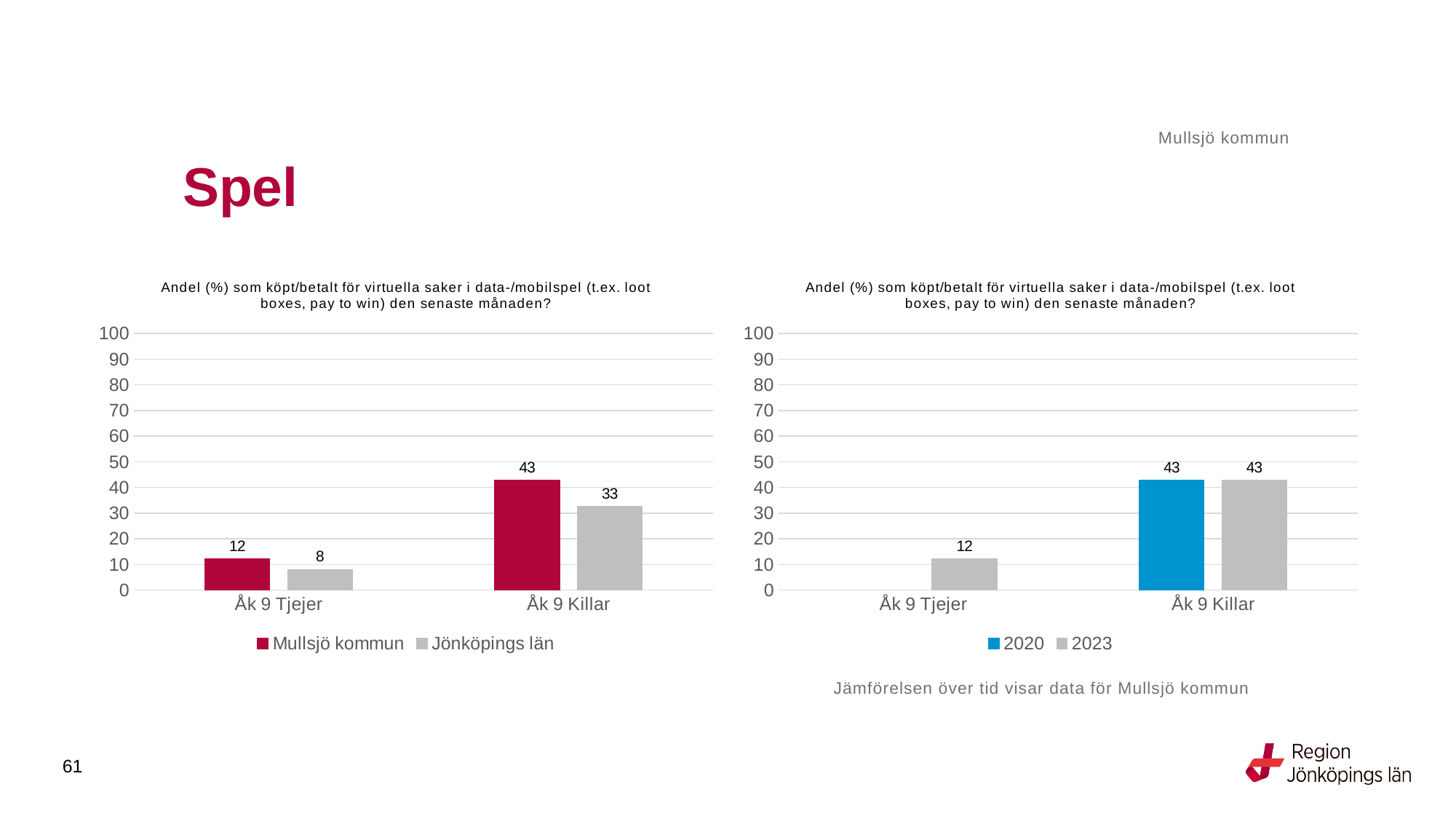
What kind of chart is the right chart? Bar chart How many categories are shown on the x axis of the right chart? 2 In the left chart, what is the value for Mullsjö kommun for Åk 9 Killar? 43 In the left chart, which category has the highest value for Jönköpings län? Åk 9 Killar In the right chart, which series is shown in blue? 2020 In the left chart, what is the difference between Mullsjö kommun and Jönköpings län for Åk 9 Killar? 10 In the right chart, what is the difference between 2020 and 2023 for Åk 9 Killar? 0 In the right chart, what is the value for 2020 for Åk 9 Killar? 43 In the right chart, what is the value for 2023 for Åk 9 Tjejer? 12 In the left chart, what is the value for Jönköpings län for Åk 9 Tjejer? 8 How many series does the legend of the left chart list? 2 In the left chart, which is larger for Åk 9 Tjejer: Mullsjö kommun or Jönköpings län? Mullsjö kommun